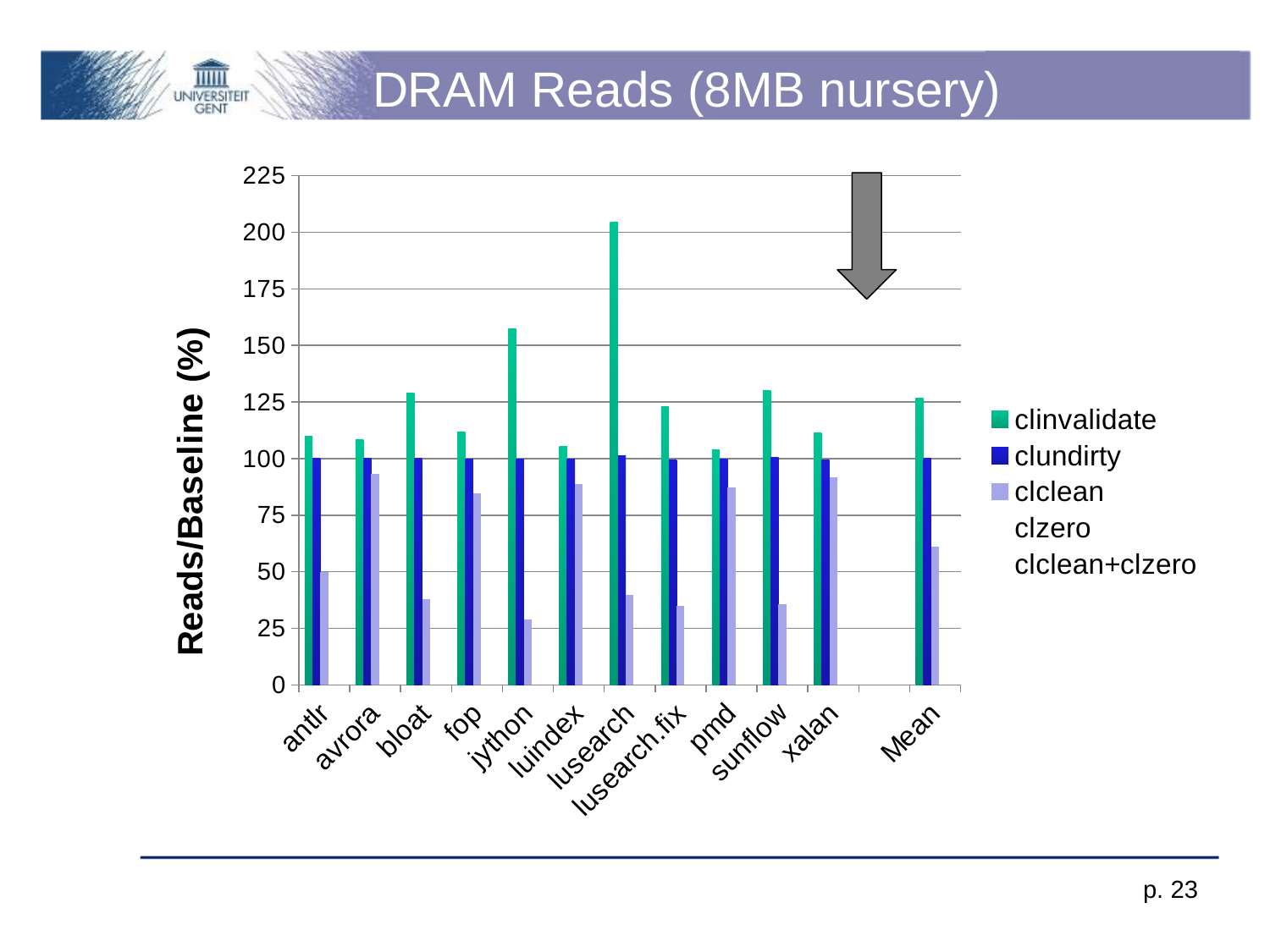
Is the clclean value for Mean greater or less than 75? less Which is larger, the clinvalidate value for jython or for fop? jython What kind of chart is shown on the slide? bar chart Is the clinvalidate value for jython greater or less than 150? greater Which category has the lowest clclean value? jython Which category has the highest clinvalidate value? lusearch What is the title of the chart? DRAM Reads (8MB nursery) Is the clclean value for avrora greater or less than 75? greater How many entries does the legend list? 5 How many categories are shown along the x axis? 12 What is the label of the y axis? Reads/Baseline (%)